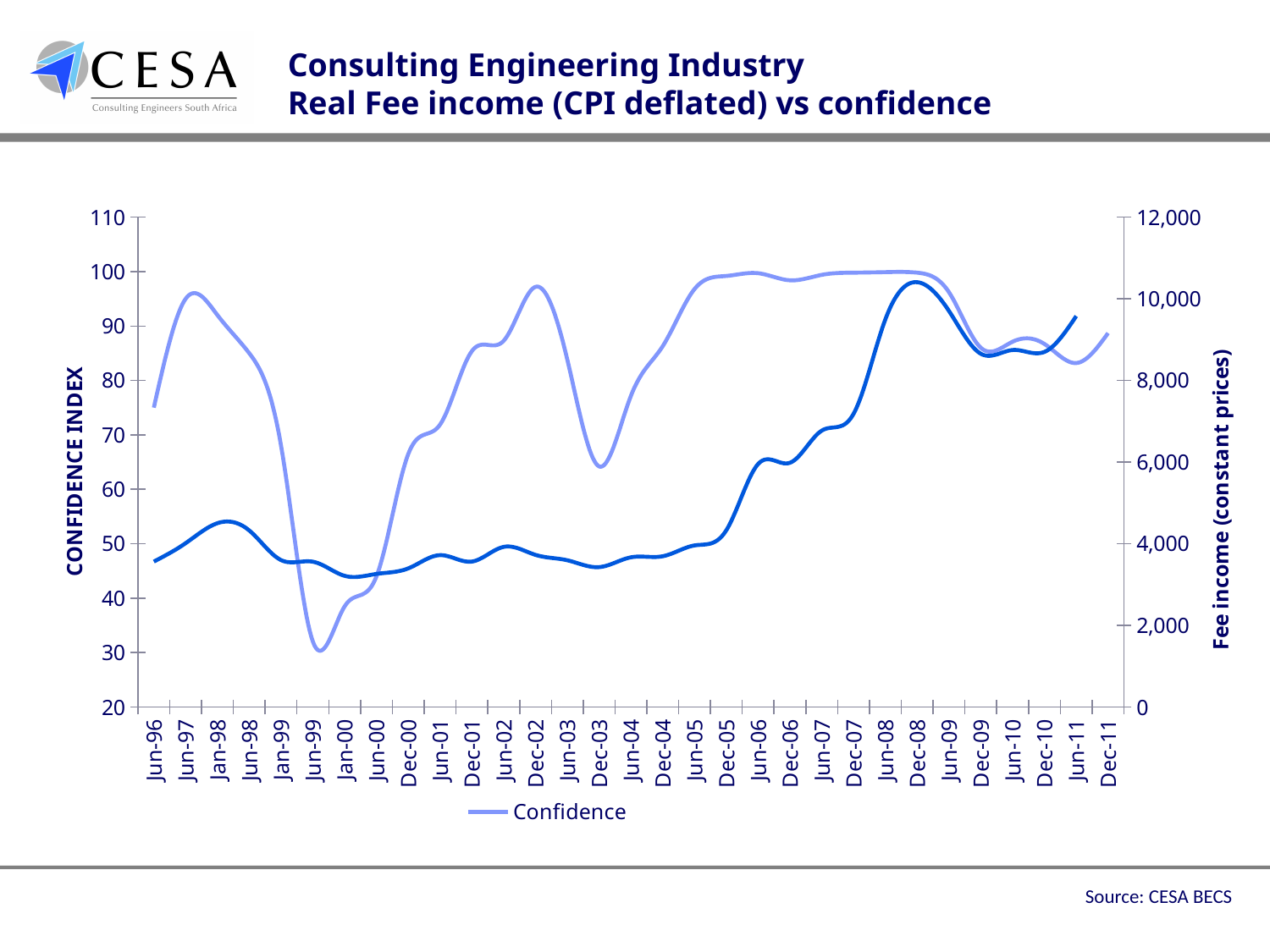
Does the fee income line rise or fall between Dec-05 and Dec-08? Rise What kind of chart is shown on the slide? Line chart Is the fee income value at Jun-96 greater or less than 4,000 on the right axis? less What is the title of the left vertical axis? CONFIDENCE INDEX Is the Confidence value at Jun-99 greater or less than 40? less At which x-axis date does the Confidence line reach its lowest point? Jun-99 Is the Confidence value at Jun-97 greater or less than 90? greater What is the title of the right vertical axis? Fee income (constant prices) How many series does the chart's legend list? 1 Which is larger, the Confidence value at Jun-97 or at Jun-99? Jun-97